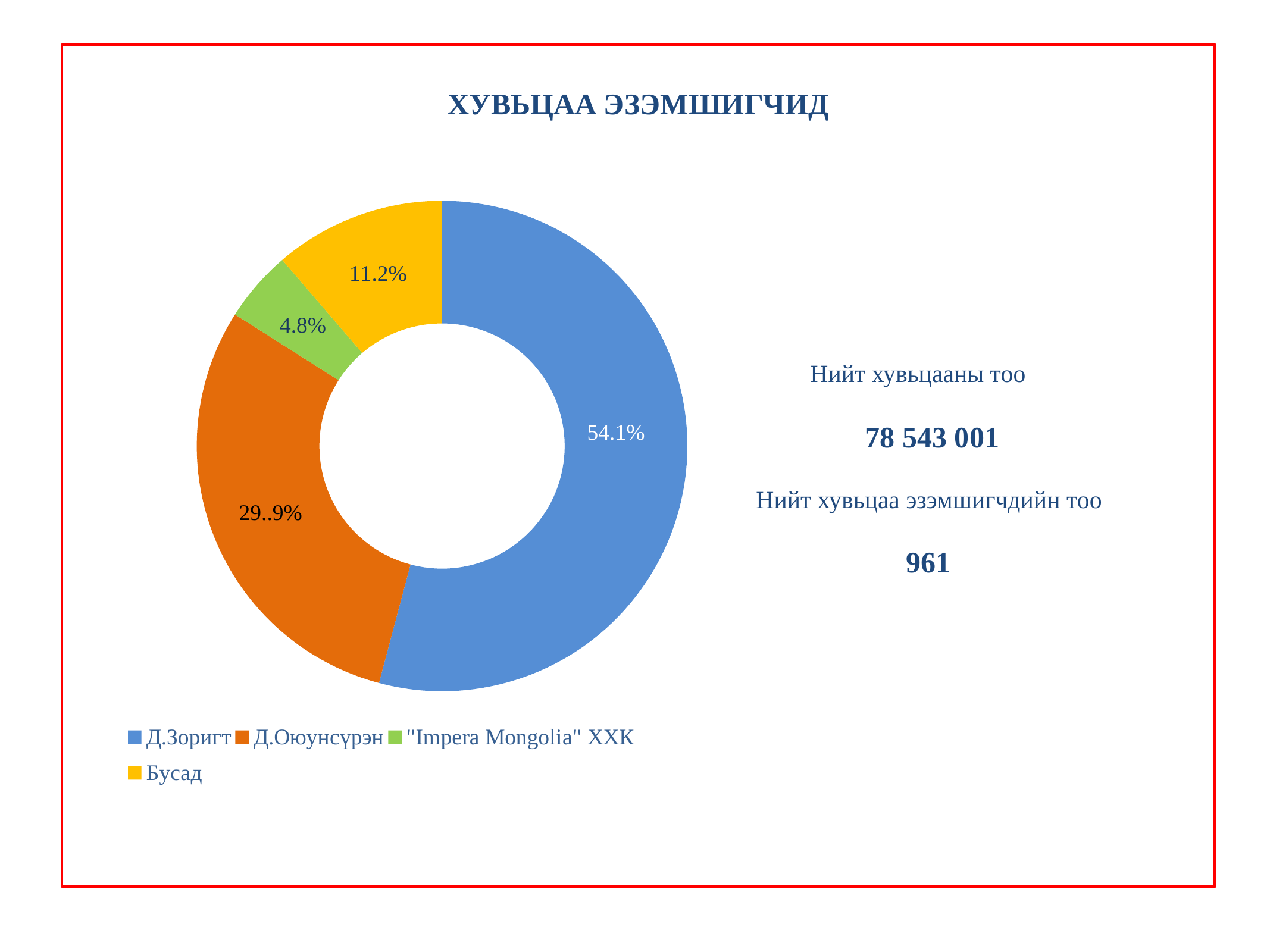
What share of the chart does Бусад hold? 11.2% What colour is the slice for Д.Зоригт? Blue What share of the chart does Д.Зоригт hold? 54.1% What share of the chart does "Impera Mongolia" ХХК hold? 4.8% Which is larger, the slice for Бусад or the slice for "Impera Mongolia" ХХК? Бусад Which category has the largest slice? Д.Зоригт Which is larger, the slice for Д.Оюунсүрэн or the slice for Бусад? Д.Оюунсүрэн What is the difference in percentage points between the Д.Зоригт slice and the Бусад slice? 42.9 What is the title of the chart? ХУВЬЦАА ЭЗЭМШИГЧИД How many slices does the chart have? 4 Which category has the smallest slice? "Impera Mongolia" ХХК What kind of chart is shown on the slide? Doughnut (pie) chart